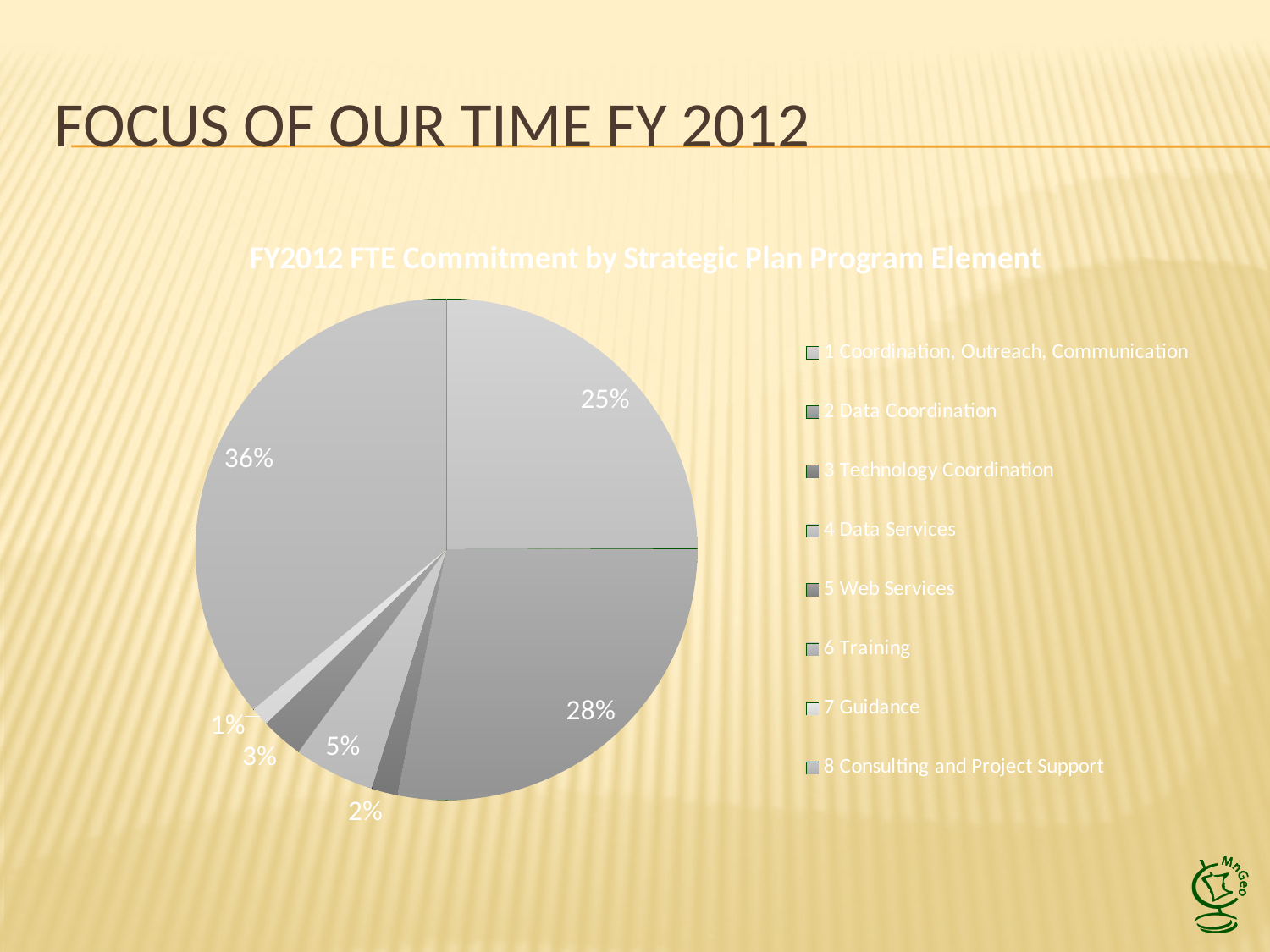
Which legend entry is listed first? 1 Coordination, Outreach, Communication Which is larger, the slice labelled 25% or the slice labelled 28%? 28% What is the combined share of the slices labelled 5%, 3%, 2% and 1%? 11% What is the value of the largest slice of the pie? 36% How many entries does the chart's legend list? 8 How many percentage data labels are printed on the pie? 7 What is the combined share of the two largest slices, 36% and 28%? 64% What is the title of the chart? FY2012 FTE Commitment by Strategic Plan Program Element Is the largest slice of the pie greater or less than 30%? greater What kind of chart is shown on the slide? pie chart What is the value of the smallest labelled slice of the pie? 1% What is the difference between the largest slice (36%) and the second-largest slice (28%)? 8 percentage points